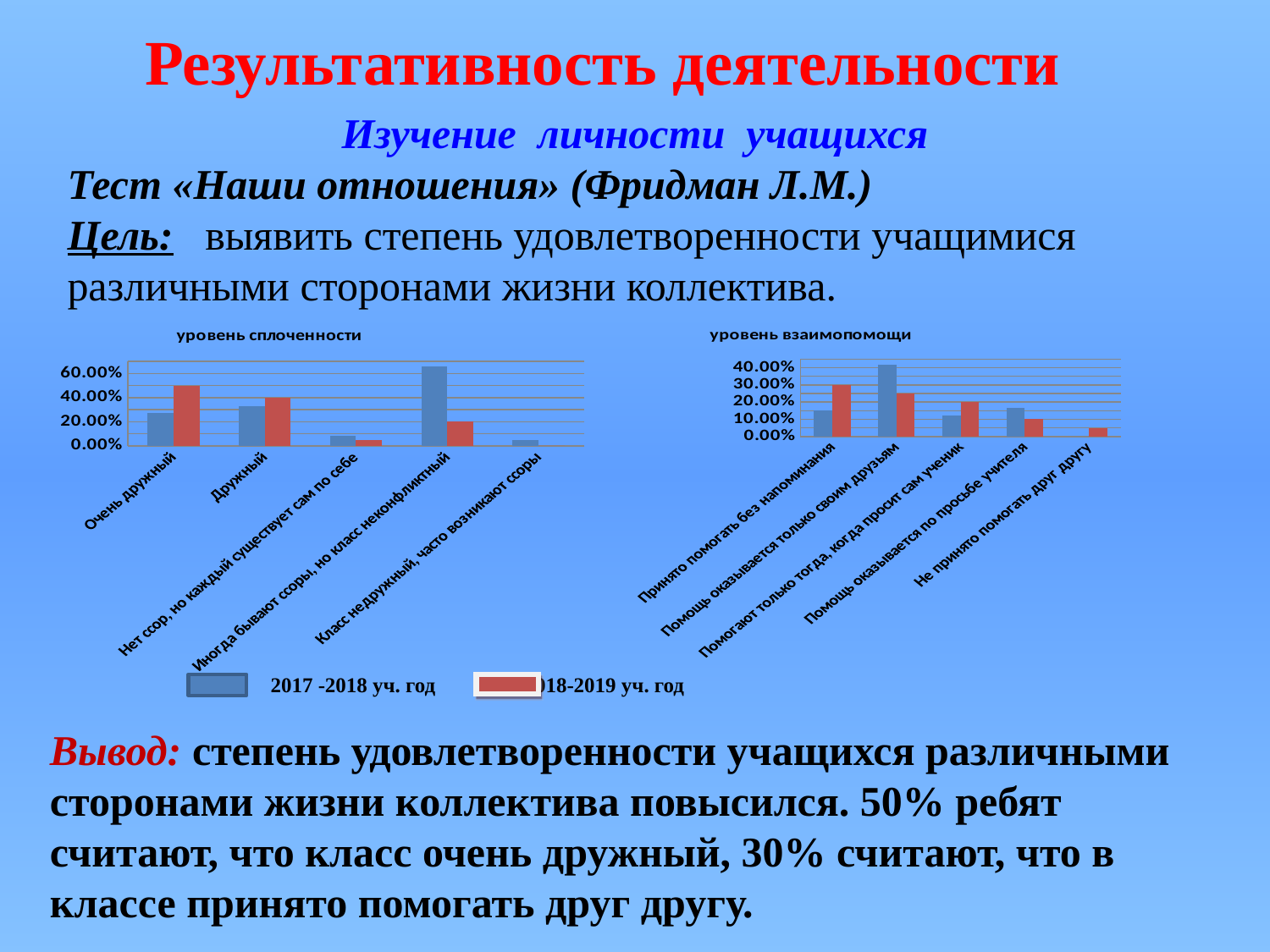
In the "уровень сплоченности" chart, which category has the highest value for the 2018-2019 уч. год series? Очень дружный In the "уровень взаимопомощи" chart, which category has the highest value for the 2018-2019 уч. год series? Принято помогать без напоминания In the "уровень взаимопомощи" chart, which category has the highest value for the 2017-2018 уч. год series? Помощь оказывается только своим друзьям In the "уровень сплоченности" chart, is the 2018-2019 уч. год value for "Очень дружный" greater or less than 40.00%? greater In the "уровень взаимопомощи" chart, for the category "Помощь оказывается по просьбе учителя", which series has the larger value: 2017-2018 уч. год or 2018-2019 уч. год? 2017-2018 уч. год In the "уровень сплоченности" chart, for the category "Очень дружный", which series has the larger value: 2017-2018 уч. год or 2018-2019 уч. год? 2018-2019 уч. год How many categories are shown on the x axis of the "уровень сплоченности" chart? 5 What kind of chart is the "уровень сплоченности" chart on the left? bar chart How many series does the legend below the charts list? 2 How many categories are shown on the x axis of the "уровень взаимопомощи" chart? 5 In the "уровень взаимопомощи" chart, is the 2017-2018 уч. год value for "Помощь оказывается только своим друзьям" greater or less than 30.00%? greater